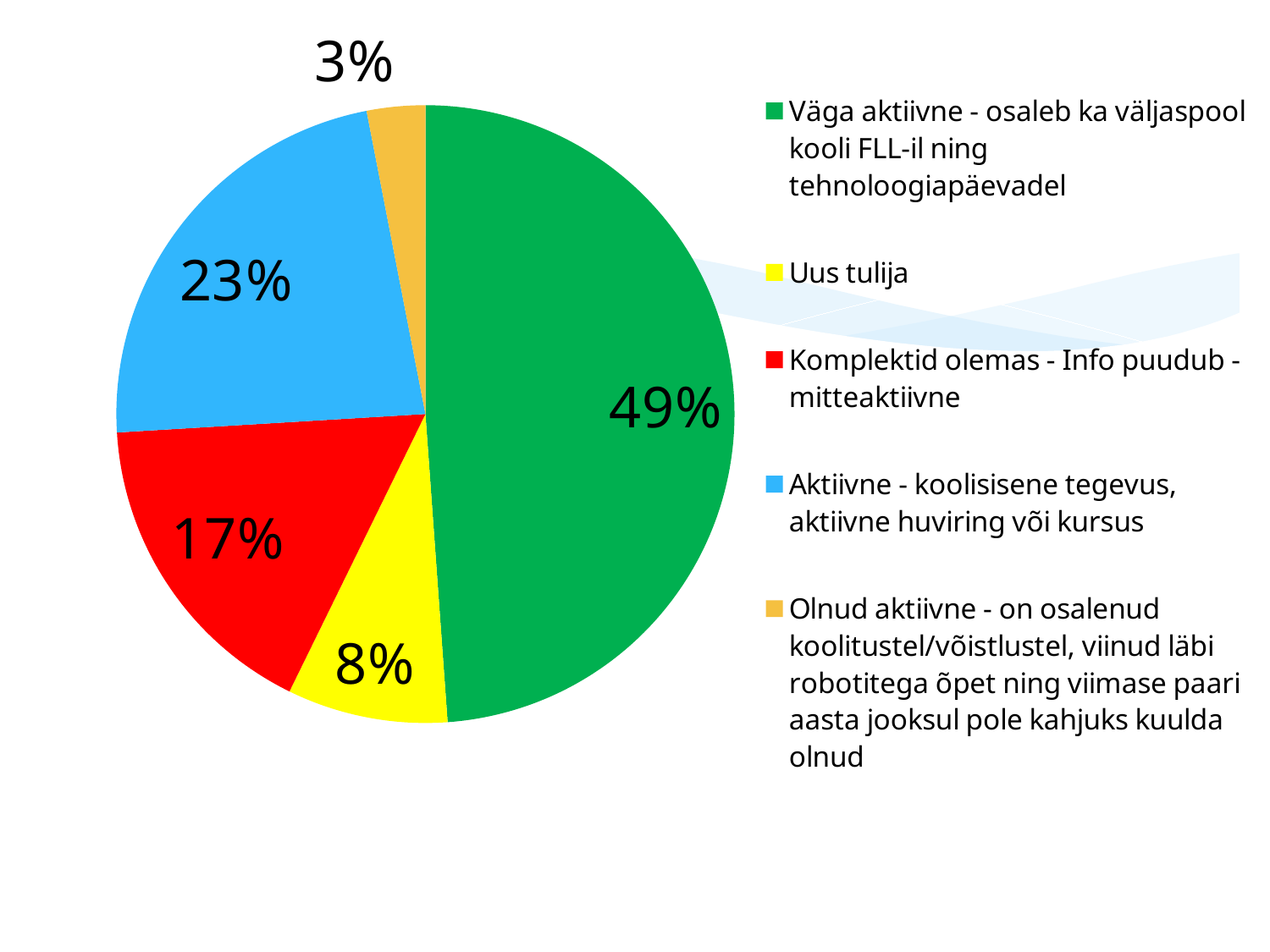
What share of the pie is the 'Väga aktiivne - osaleb ka väljaspool kooli FLL-il ning tehnoloogiapäevadel' slice? 49% What share of the pie is the 'Komplektid olemas - Info puudub - mitteaktiivne' slice? 17% What share of the pie is the 'Aktiivne - koolisisene tegevus, aktiivne huviring või kursus' slice? 23% How many slices does the pie chart have? 5 What is the difference in percentage points between the 'Aktiivne - koolisisene tegevus' slice and the 'Komplektid olemas' slice? 6 What kind of chart is shown on the slide? pie chart Which category has the smallest slice of the pie? Olnud aktiivne - on osalenud koolitustel/võistlustel, viinud läbi robotitega õpet ning viimase paari aasta jooksul pole kahjuks kuulda olnud Which is larger, the 'Uus tulija' slice or the 'Komplektid olemas - Info puudub - mitteaktiivne' slice? Komplektid olemas - Info puudub - mitteaktiivne Which category has the largest slice of the pie? Väga aktiivne - osaleb ka väljaspool kooli FLL-il ning tehnoloogiapäevadel What colour is the 'Uus tulija' slice in the pie chart? yellow